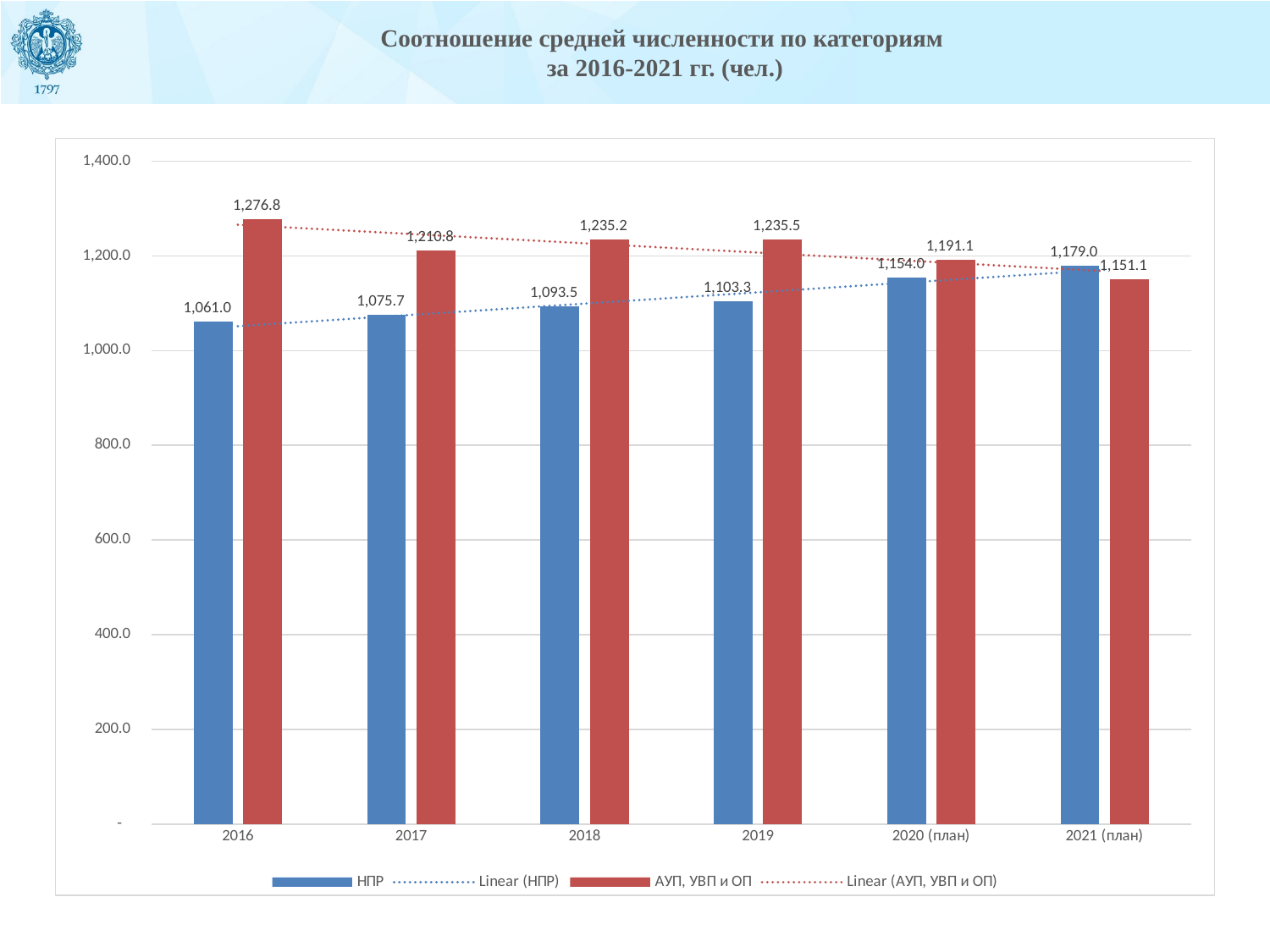
What is the difference between АУП, УВП и ОП and НПР in 2016? 215.8 In which year is the АУП, УВП и ОП value lowest? 2021 (план) In which year is the НПР value highest? 2021 (план) In 2021 (план), which series has the larger value, НПР or АУП, УВП и ОП? НПР What is the difference between НПР and АУП, УВП и ОП in 2021 (план)? 27.9 What is the value for НПР in 2016? 1,061.0 Do the НПР values rise or fall from 2016 to 2021 (план)? Rise What kind of chart is shown on the slide? Bar chart How many year categories are shown on the x axis? 6 How many entries does the legend list? 4 What is the value for АУП, УВП и ОП in 2019? 1,235.5 What is the value for АУП, УВП и ОП in 2017? 1,210.8